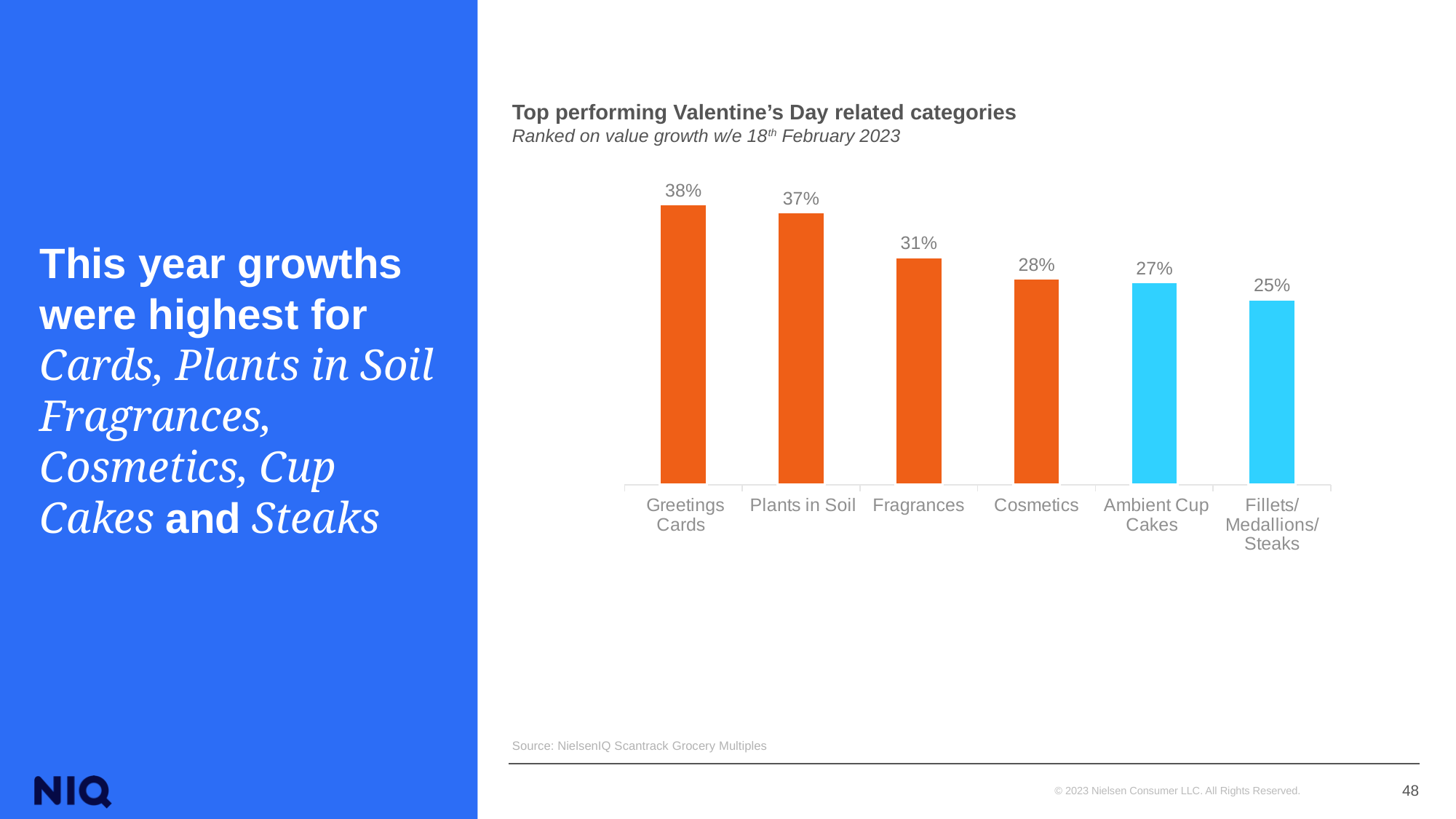
What is the title of the chart? Top performing Valentine's Day related categories What is the difference in value growth between Plants in Soil and Cosmetics? 9% What is the value growth for Greetings Cards? 38% Which categories are shown with light blue bars rather than orange? Ambient Cup Cakes and Fillets/ Medallions/ Steaks What is the value growth for Fragrances? 31% Which has higher value growth, Fragrances or Ambient Cup Cakes? Fragrances How many categories are shown in the chart? 6 Which category has the highest value growth? Greetings Cards Which category has the lowest value growth? Fillets/ Medallions/ Steaks What kind of chart is shown on the slide? Bar chart Do the values rise or fall from left to right across the categories? Fall What is the value growth for Ambient Cup Cakes? 27%